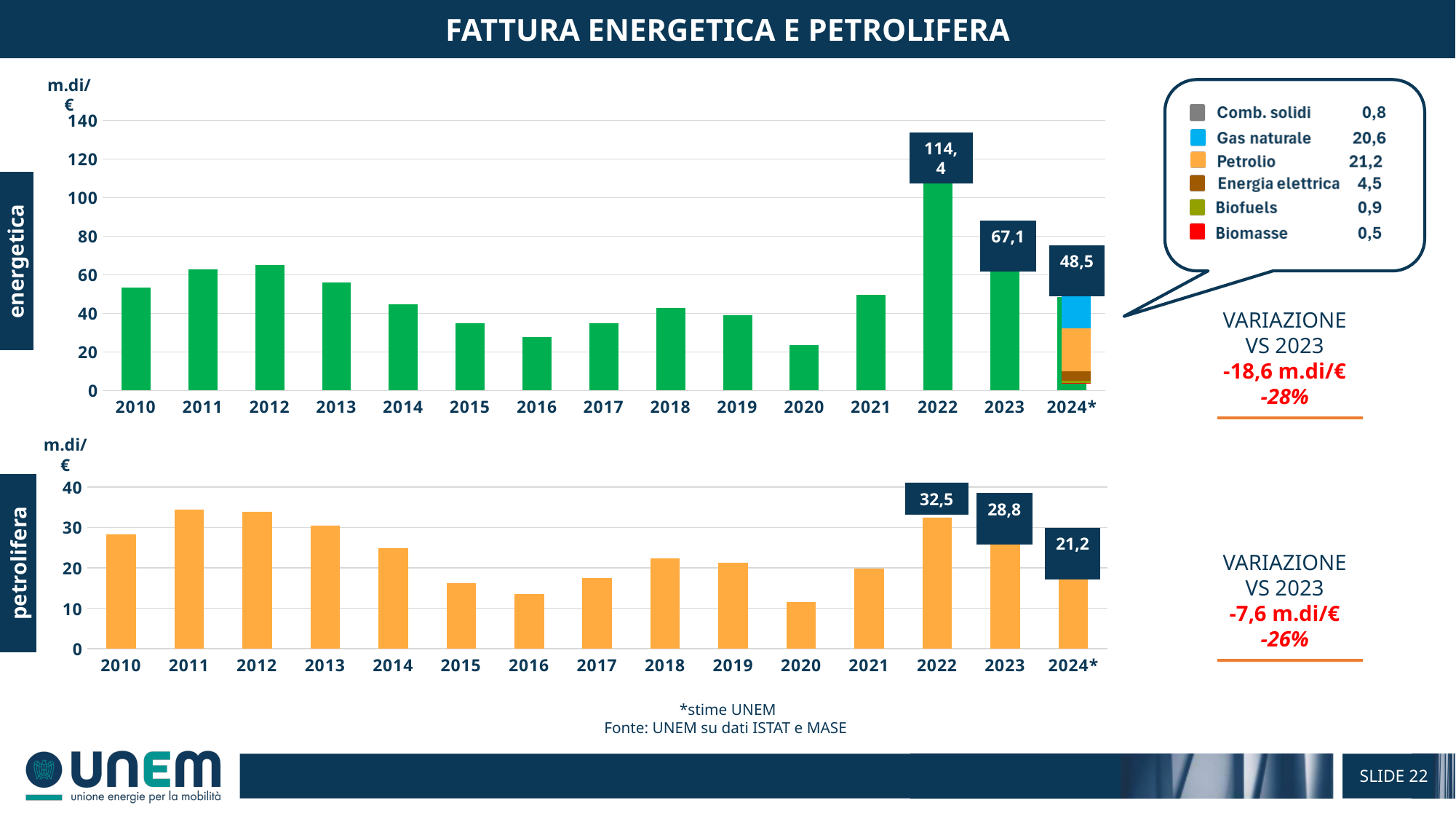
In the bottom chart (petrolifera), what is the value for 2022? 32,5 In the top chart (energetica), which year has the lowest value? 2020 In the top chart (energetica), what is the value for 2022? 114,4 In the top chart (energetica), what is the difference between the 2022 and 2023 values? 47,3 How many years are shown on the x axis of the bottom chart (petrolifera)? 15 In the top chart (energetica), what value does the legend give for Gas naturale in 2024*? 20,6 In the bottom chart (petrolifera), what is the difference between the 2023 and 2024* values? 7,6 In the bottom chart (petrolifera), which is larger, the value for 2013 or the value for 2014? 2013 In the top chart (energetica), what is the value for 2024*? 48,5 In the bottom chart (petrolifera), what is the value for 2023? 28,8 In the top chart (energetica), is the value for 2012 greater or less than 60? greater In the top chart (energetica), which year has the highest value? 2022